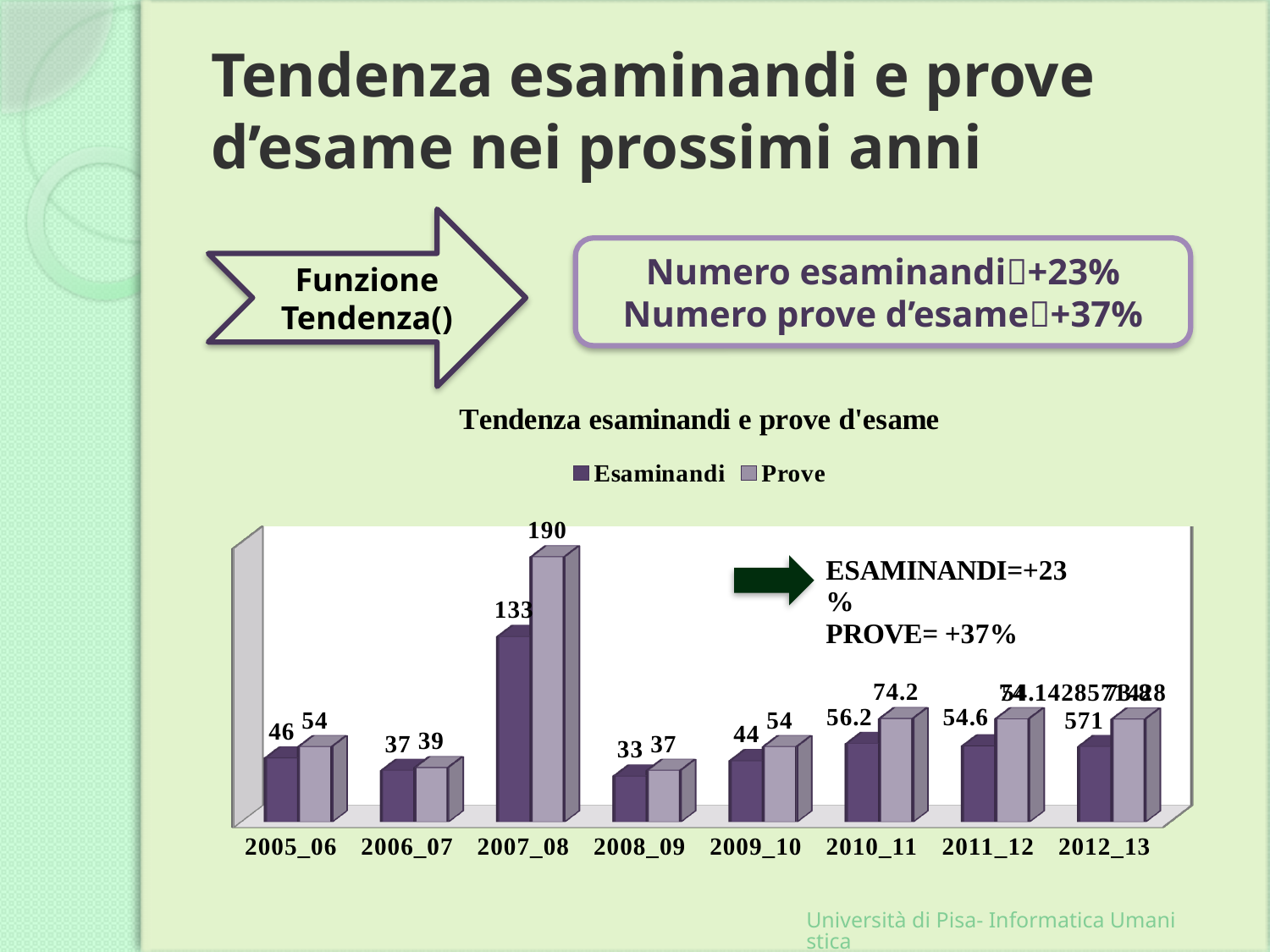
Which is larger: Esaminandi in 2005_06 or Esaminandi in 2009_10? 2005_06 Which year has the highest value for Prove? 2007_08 How many academic years are shown on the x axis? 8 What is the difference between Prove and Esaminandi in 2010_11? 18 Which year has the lowest value for Esaminandi? 2008_09 What is the value of Prove for 2010_11? 74.2 What is the value of Esaminandi for 2006_07? 37 How many series does the legend list? 2 What kind of chart is shown on the slide? bar chart What is the difference between Prove and Esaminandi in 2007_08? 57 What is the value of Esaminandi for 2007_08? 133 What is the value of Prove for 2005_06? 54